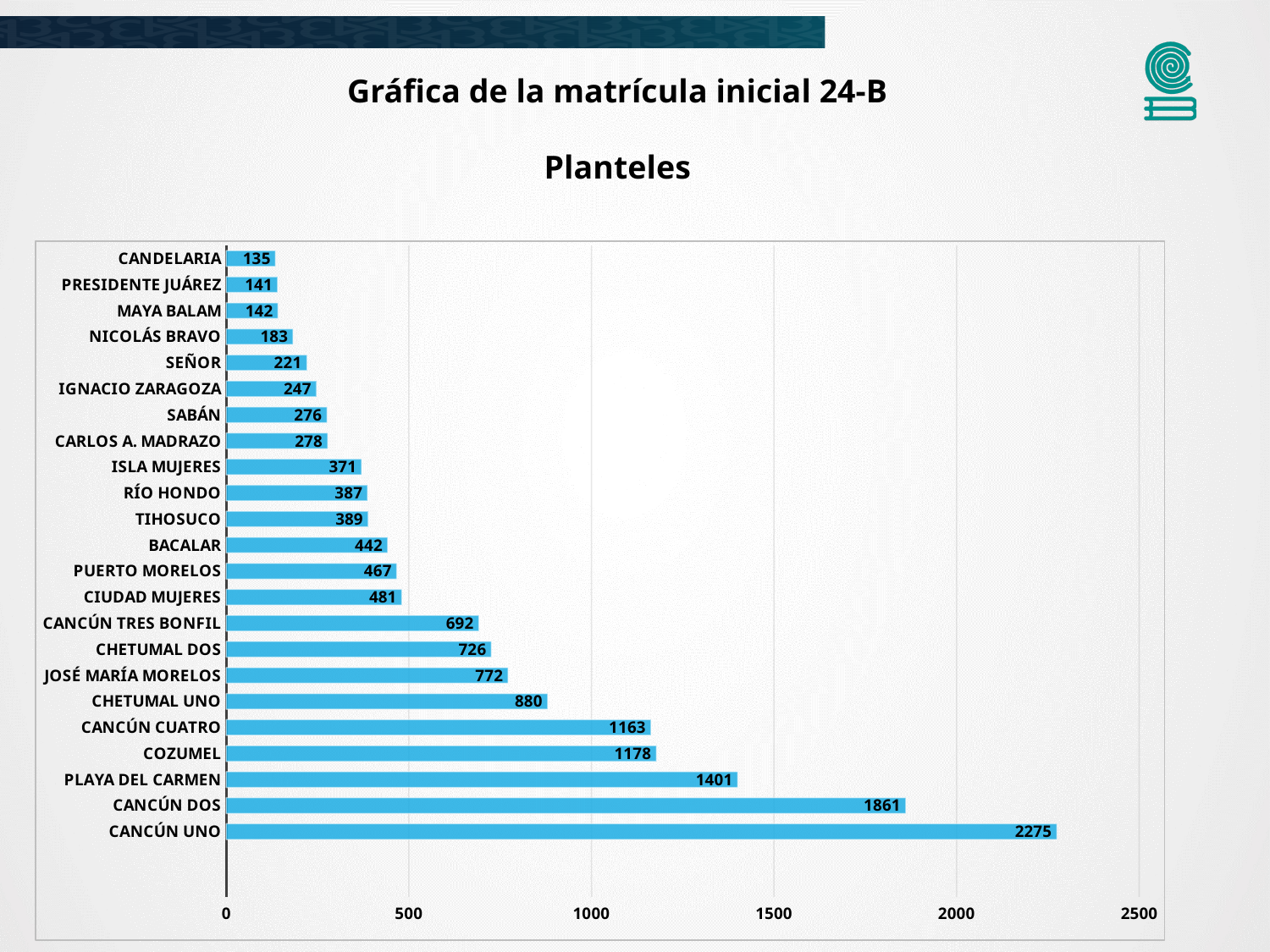
Which plantel has the lowest value? CANDELARIA What is the value for ISLA MUJERES? 371 What is the value for PLAYA DEL CARMEN? 1401 Is the value for JOSÉ MARÍA MORELOS greater or less than 500? greater What kind of chart is shown on the slide? Bar chart Which is larger, the value for BACALAR or the value for TIHOSUCO? BACALAR What is the title of the chart? Planteles What is the difference between the values for CHETUMAL DOS and CANCÚN TRES BONFIL? 34 What is the difference between the values for CANCÚN UNO and CANCÚN DOS? 414 What is the value for CHETUMAL UNO? 880 How many planteles are shown in the chart? 23 Which plantel has the highest value? CANCÚN UNO